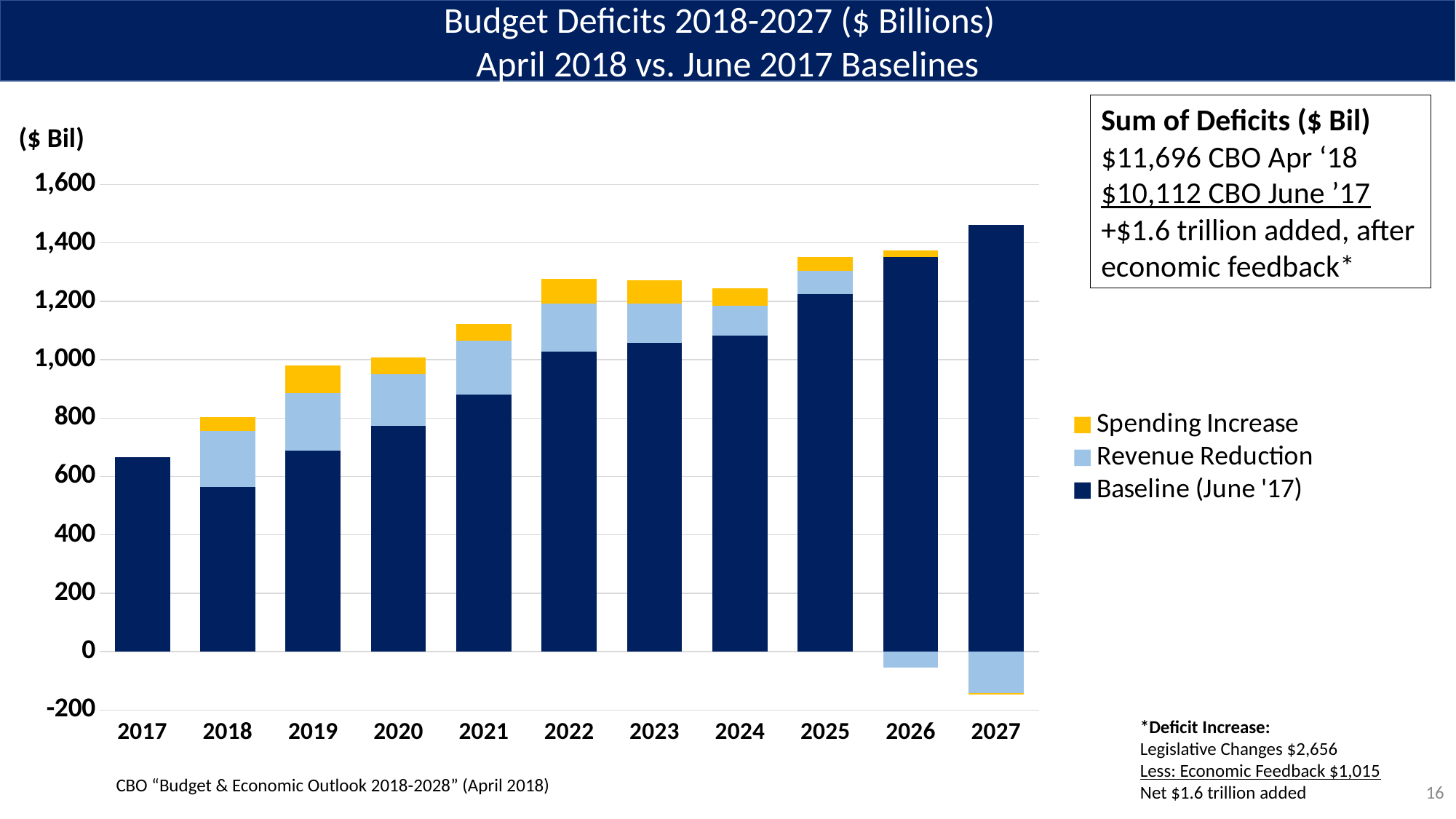
Is the Baseline (June '17) value for 2021 greater or less than 1,000? less Which colour represents Spending Increase in the chart's legend? Yellow How many years are shown along the x axis of the chart? 11 Is the Baseline (June '17) value for 2018 greater or less than 600? less Which year has the lowest Baseline (June '17) value? 2018 Which year has the highest Baseline (June '17) value? 2027 How many series does the chart's legend list? 3 Is the Baseline (June '17) value for 2017 greater or less than 600? greater Which is larger, the Baseline (June '17) value for 2027 or for 2017? 2027 What kind of chart is shown on the slide? Stacked bar chart Does the Baseline (June '17) series generally rise or fall from 2018 to 2027? Rise